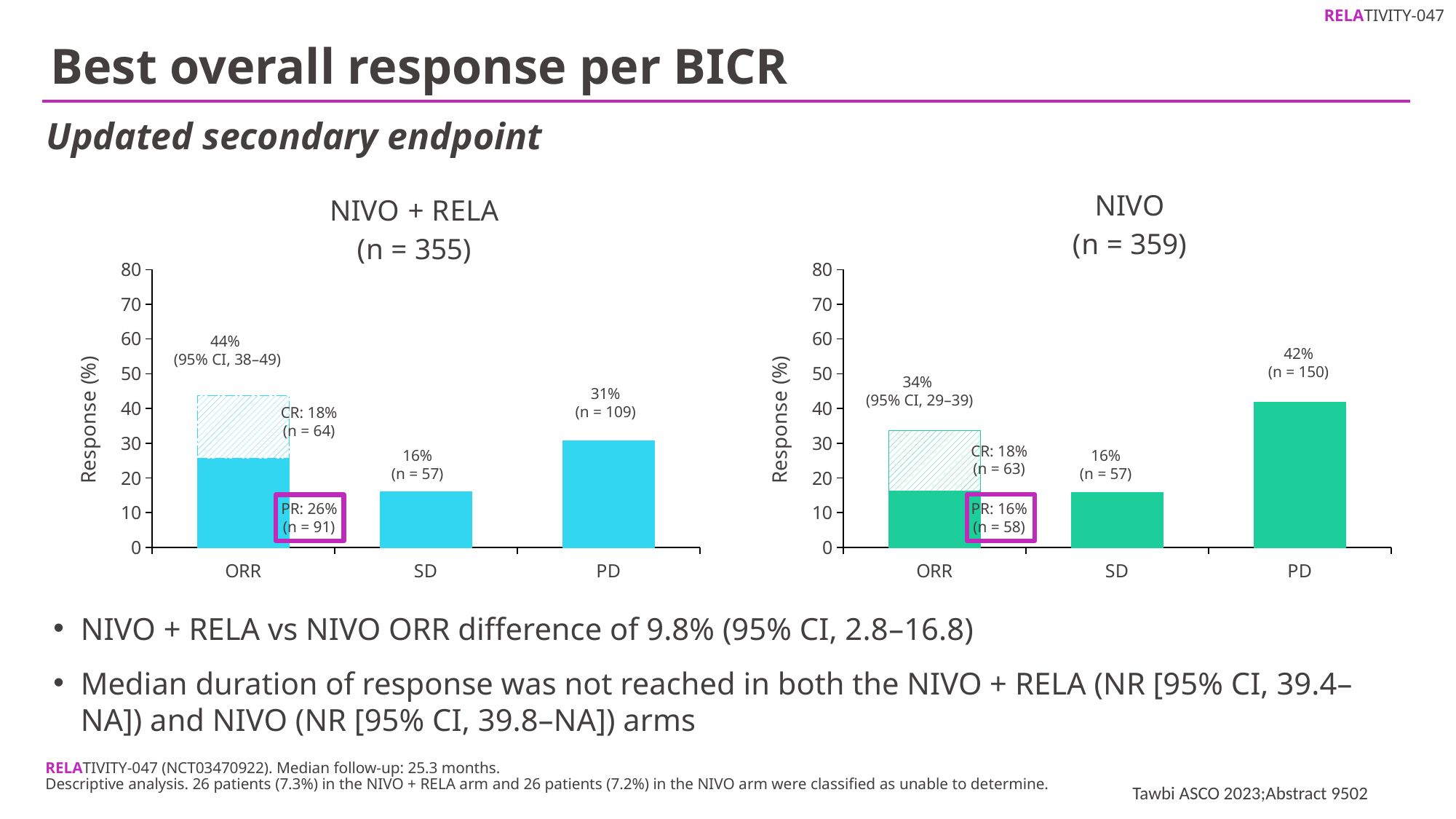
What is the y-axis label on the NIVO + RELA chart? Response (%) What kind of chart is the NIVO chart? bar chart In the NIVO chart, how many patients had a complete response (CR)? n = 63 How many categories are shown on the x axis of the NIVO + RELA chart? 3 In the NIVO chart, which category has the lowest value? SD In the NIVO chart, is the value for PD greater or less than 40? greater Which is larger: the PD value in the NIVO + RELA chart or the PD value in the NIVO chart? NIVO In the NIVO + RELA chart, what is the ORR value? 44% In the NIVO + RELA chart, which category has the highest value? ORR In the NIVO + RELA chart, what is the PR percentage within the ORR bar? 26% In the NIVO chart, what is the PD value? 42% What is the difference between the ORR values in the NIVO + RELA chart and the NIVO chart? 10%